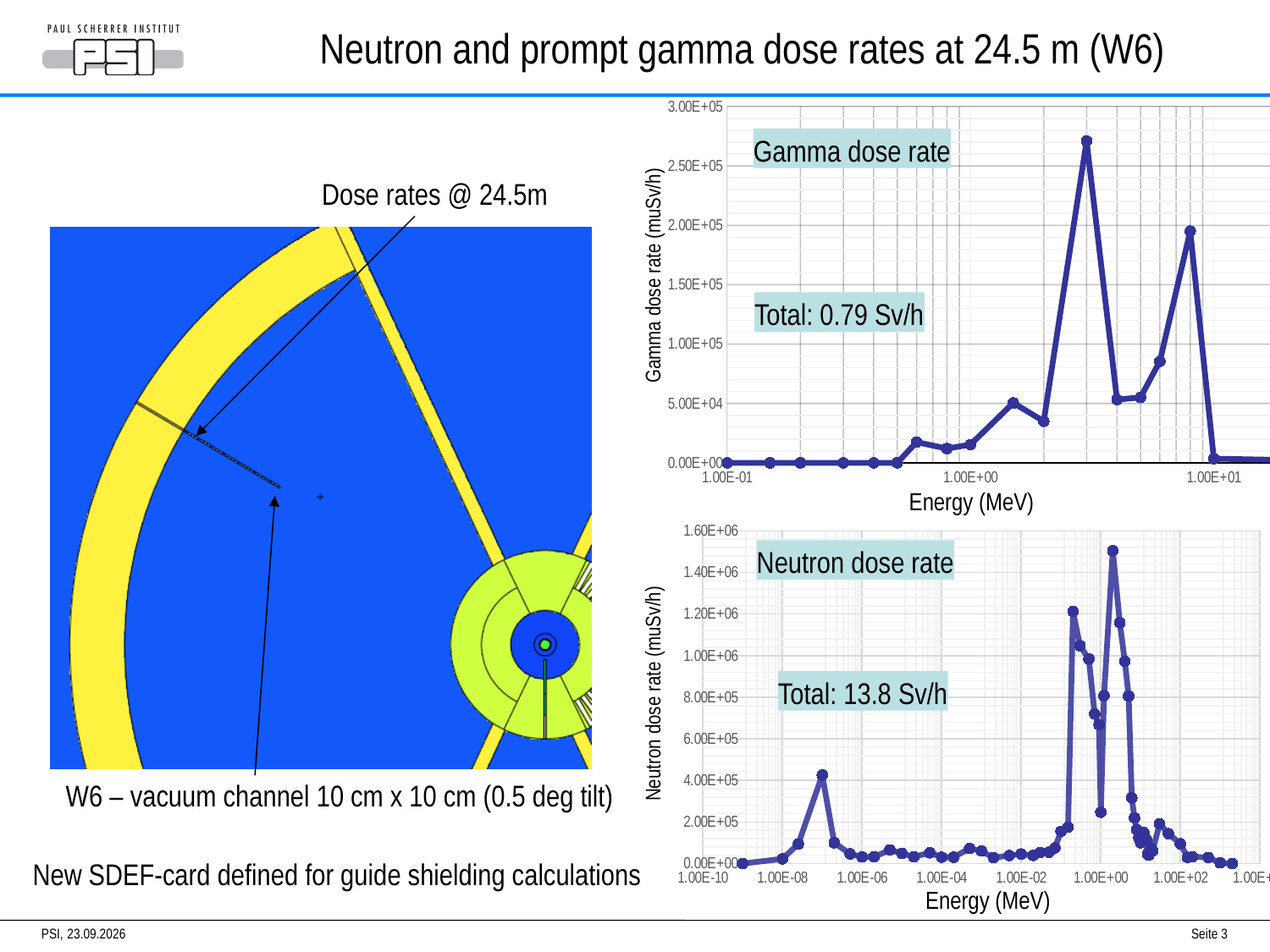
In the Neutron dose rate chart, is the highest peak value greater or less than 1.40E+06? greater In the Gamma dose rate chart, is the value at 1.00E-01 MeV greater or less than 5.00E+04? less What kind of chart is the Gamma dose rate chart? line chart In the Gamma dose rate chart, is the highest peak value greater or less than 2.50E+05? greater Which total is larger, the gamma dose rate total or the neutron dose rate total? neutron dose rate total In the Gamma dose rate chart, what total dose rate is stated in the text box? 0.79 Sv/h What is the y-axis label of the Gamma dose rate chart? Gamma dose rate (muSv/h) What is the maximum value shown on the y-axis of the Neutron dose rate chart? 1.60E+06 What is the x-axis label of the Neutron dose rate chart? Energy (MeV) In the Neutron dose rate chart, what total dose rate is stated in the text box? 13.8 Sv/h What kind of chart is the Neutron dose rate chart? line chart